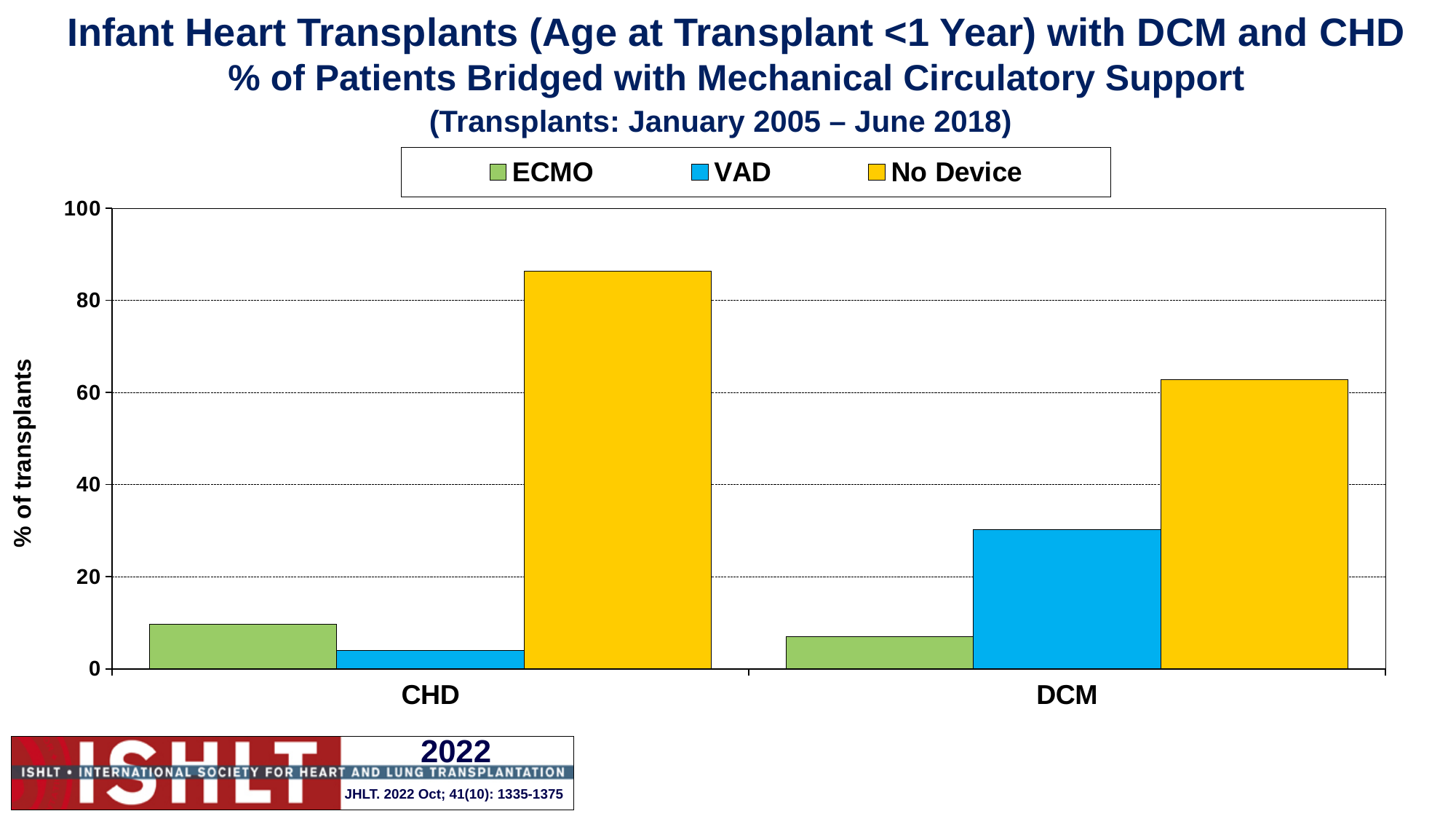
Which series has the highest value for CHD? No Device Is the ECMO value for CHD greater or less than 20? less Which series has the lowest value for CHD? VAD Which series has the lowest value for DCM? ECMO How many diagnosis categories are shown on the x axis? 2 Is the No Device value for DCM greater or less than 80? less Is the No Device value for CHD greater or less than 80? greater How many series does the legend list? 3 What is the label of the y axis? % of transplants Which is larger, the VAD value for CHD or the VAD value for DCM? DCM What kind of chart is shown on the slide? bar chart